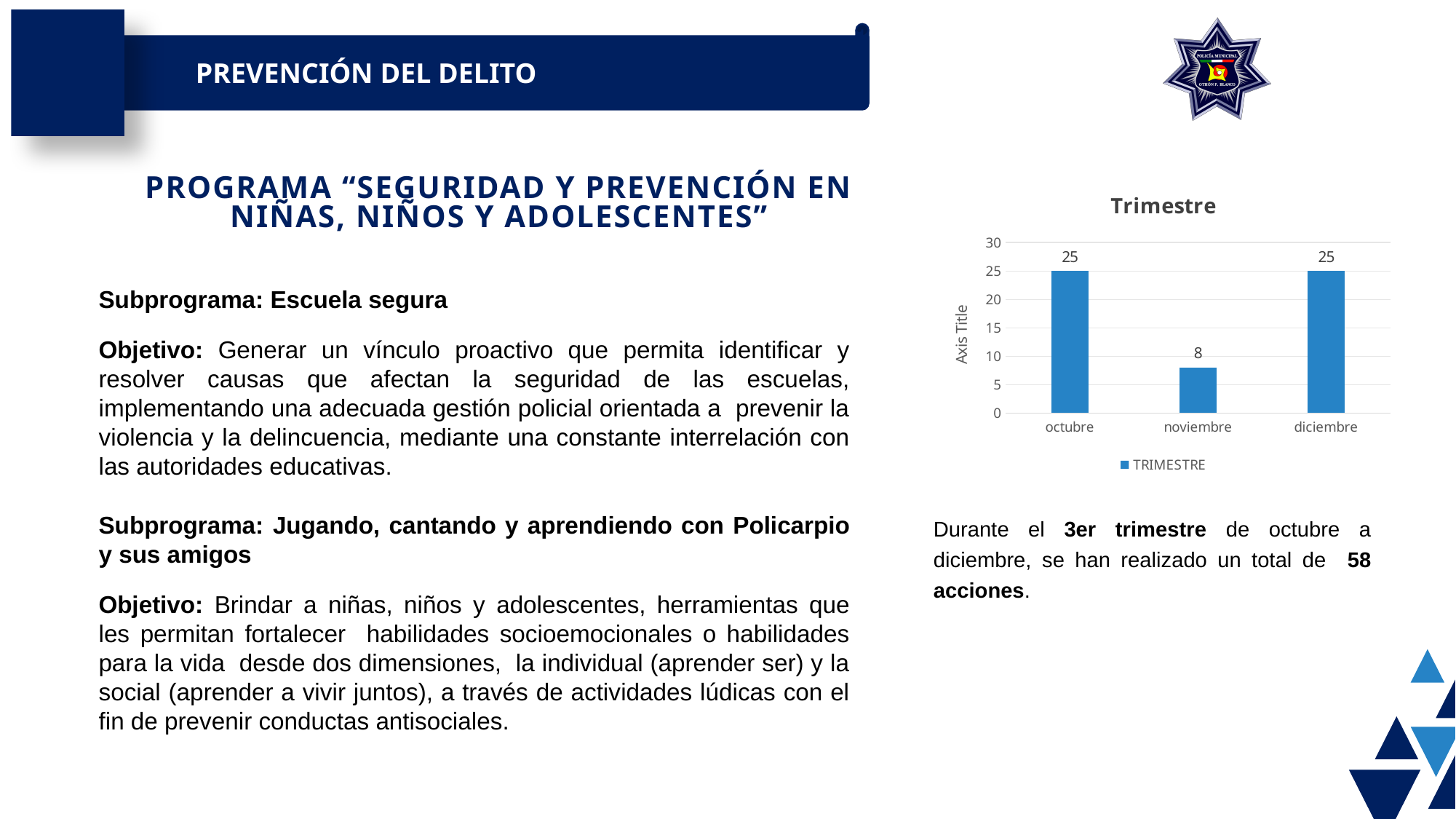
What is the value for noviembre in the Trimestre chart? 8 How many series does the chart legend list? 1 How many months are shown on the x axis of the chart? 3 What is the name of the series listed in the chart legend? TRIMESTRE What is the value for octubre in the Trimestre chart? 25 Which month has the lowest value in the Trimestre chart? noviembre What kind of chart is shown on the slide? bar chart What is the title of the chart? Trimestre Which is larger, the value for noviembre or the value for diciembre? diciembre Is the value for noviembre greater or less than 10? less What is the difference between the values for octubre and noviembre? 17 What is the value for diciembre in the Trimestre chart? 25